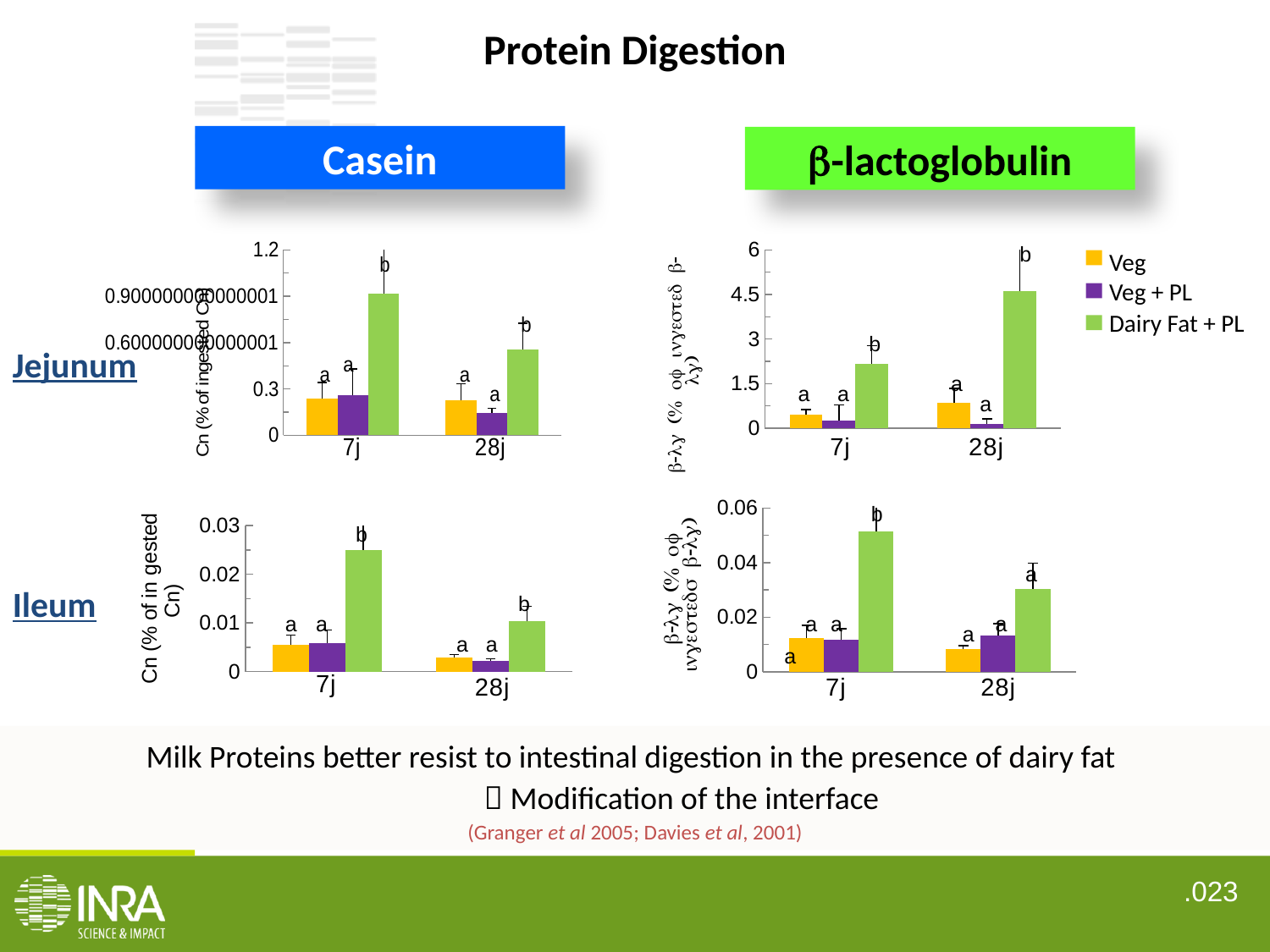
What kind of chart is the Casein Jejunum chart (top-left)? bar chart How many series does the legend list for the charts? 3 In the β-lactoglobulin Jejunum chart (top-right), which is larger for Dairy Fat + PL: the value at 7j or at 28j? 28j In the Casein Jejunum chart (top-left), does the Dairy Fat + PL value rise or fall from 7j to 28j? fall In the Casein Jejunum chart (top-left), which series has the highest bar at 7j? Dairy Fat + PL In the β-lactoglobulin Ileum chart (bottom-right), is the value for Veg at 28j greater or less than 0.02? less In the β-lactoglobulin Jejunum chart (top-right), is the value for Dairy Fat + PL at 28j greater or less than 3? greater In the β-lactoglobulin Ileum chart (bottom-right), which series has the lowest bar at 28j? Veg In the Casein Ileum chart (bottom-left), is the value for Dairy Fat + PL at 7j greater or less than 0.02? greater How many categories are shown on the x axis of the β-lactoglobulin Ileum chart (bottom-right)? 2 What colour represents the Dairy Fat + PL series in the legend? green